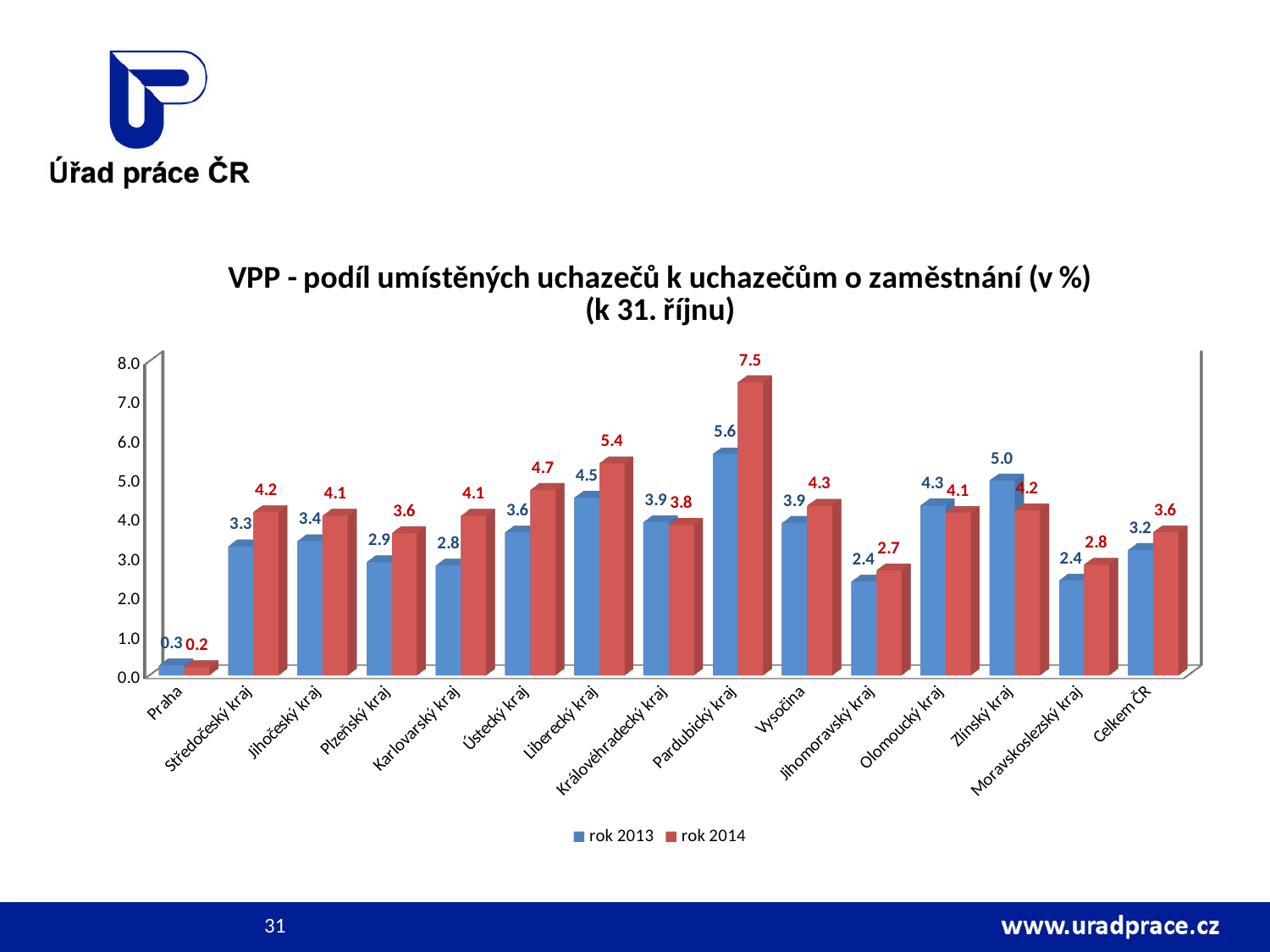
Which colour represents the rok 2014 series? red How many categories are shown on the x axis? 15 Which category has the highest value in the rok 2013 series? Pardubický kraj What is the value for Karlovarský kraj in the rok 2013 series? 2.8 Is the rok 2014 value for Liberecký kraj greater or less than 5.0? greater What is the difference between the rok 2014 and rok 2013 values for Pardubický kraj? 1.9 What is the value for Pardubický kraj in the rok 2014 series? 7.5 Which category has the lowest value in the rok 2014 series? Praha How many series does the legend list? 2 What kind of chart is shown on the slide? bar chart What is the value for Celkem ČR in the rok 2014 series? 3.6 For Zlínský kraj, which series has the larger value, rok 2013 or rok 2014? rok 2013